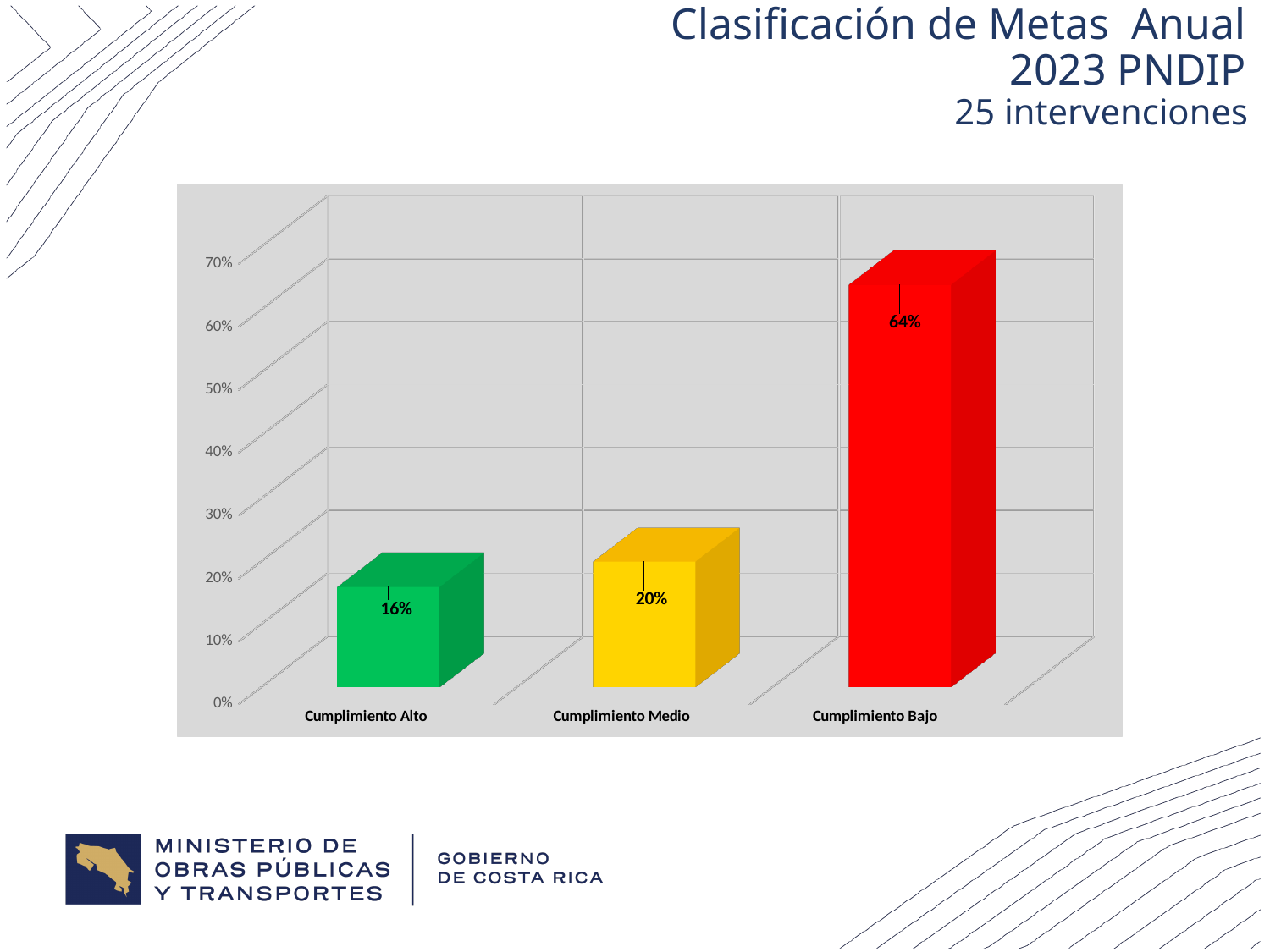
Which category has the highest value? Cumplimiento Bajo What is the value for Cumplimiento Bajo? 64% How many categories are shown in the chart? 3 Is the value for Cumplimiento Bajo greater or less than 50%? greater What kind of chart is shown on the slide? Bar chart Which is larger, the value for Cumplimiento Medio or Cumplimiento Alto? Cumplimiento Medio What is the value for Cumplimiento Medio? 20% Which category has the lowest value? Cumplimiento Alto What colour is the bar for Cumplimiento Bajo? Red What is the difference between the values for Cumplimiento Medio and Cumplimiento Alto? 4% What is the value for Cumplimiento Alto? 16% What is the difference between the values for Cumplimiento Bajo and Cumplimiento Medio? 44%